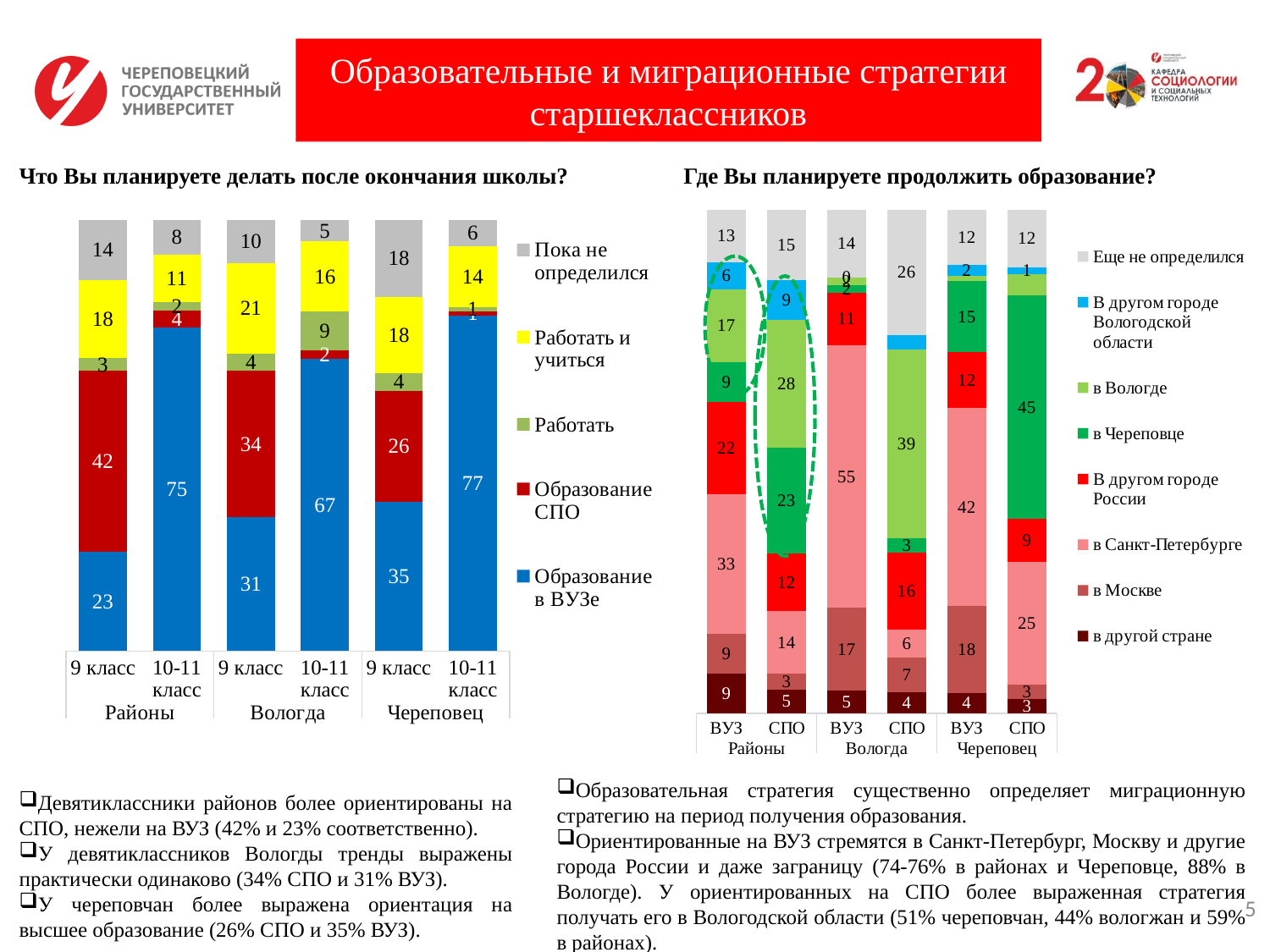
In the chart "Где Вы планируете продолжить образование?", what is the value for "в Санкт-Петербурге" for ВУЗ in Вологда? 55 In the chart "Что Вы планируете делать после окончания школы?", what is the difference between "Образование СПО" and "Образование в ВУЗе" for 9 класс in Районы? 19 In the chart "Что Вы планируете делать после окончания школы?", what is the value for "Образование СПО" for 9 класс in Вологда? 34 In the chart "Где Вы планируете продолжить образование?", how many series does the legend list? 8 In the chart "Где Вы планируете продолжить образование?", how many bars are plotted? 6 In the chart "Что Вы планируете делать после окончания школы?", which is larger for 9 класс in Череповец: "Образование СПО" or "Образование в ВУЗе"? Образование в ВУЗе In the chart "Что Вы планируете делать после окончания школы?", which category has the highest value for "Образование в ВУЗе"? 10-11 класс Череповец In the chart "Что Вы планируете делать после окончания школы?", what is the total of the stacked bar for 9 класс in Районы? 100 What kind of chart is "Где Вы планируете продолжить образование?"? Stacked bar chart In the chart "Что Вы планируете делать после окончания школы?", how many series does the legend list? 5 In the chart "Где Вы планируете продолжить образование?", what is the value for "в Череповце" for СПО in Череповец? 45 In the chart "Что Вы планируете делать после окончания школы?", what is the value for "Образование в ВУЗе" for 9 класс in Районы? 23